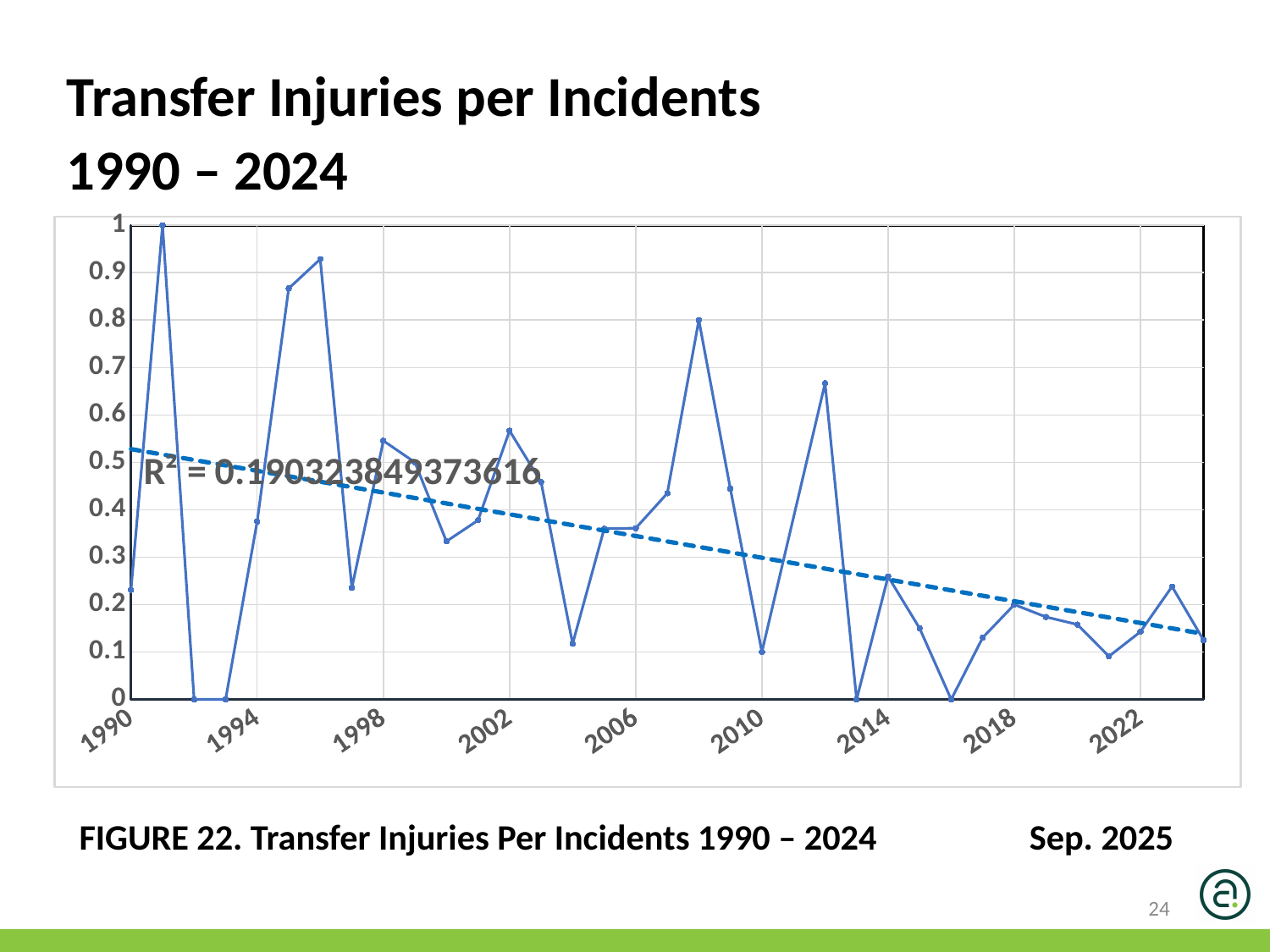
Is the value for 2010 greater or less than 0.2? less What is the highest value reached by the plotted line? 1 What R² value is printed on the chart? 0.190323849373616 Which year has the larger value, 2002 or 2022? 2002 Is the value for 1990 greater or less than 0.3? less What kind of chart is shown on the slide? line chart Which year has the larger value, 1998 or 2010? 1998 Is the value for 2006 greater or less than 0.4? less What is the title of the chart according to the figure caption? FIGURE 22. Transfer Injuries Per Incidents 1990 – 2024 What is the lowest value reached by the plotted line? 0 Does the dashed trendline rise or fall from 1990 to 2024? fall